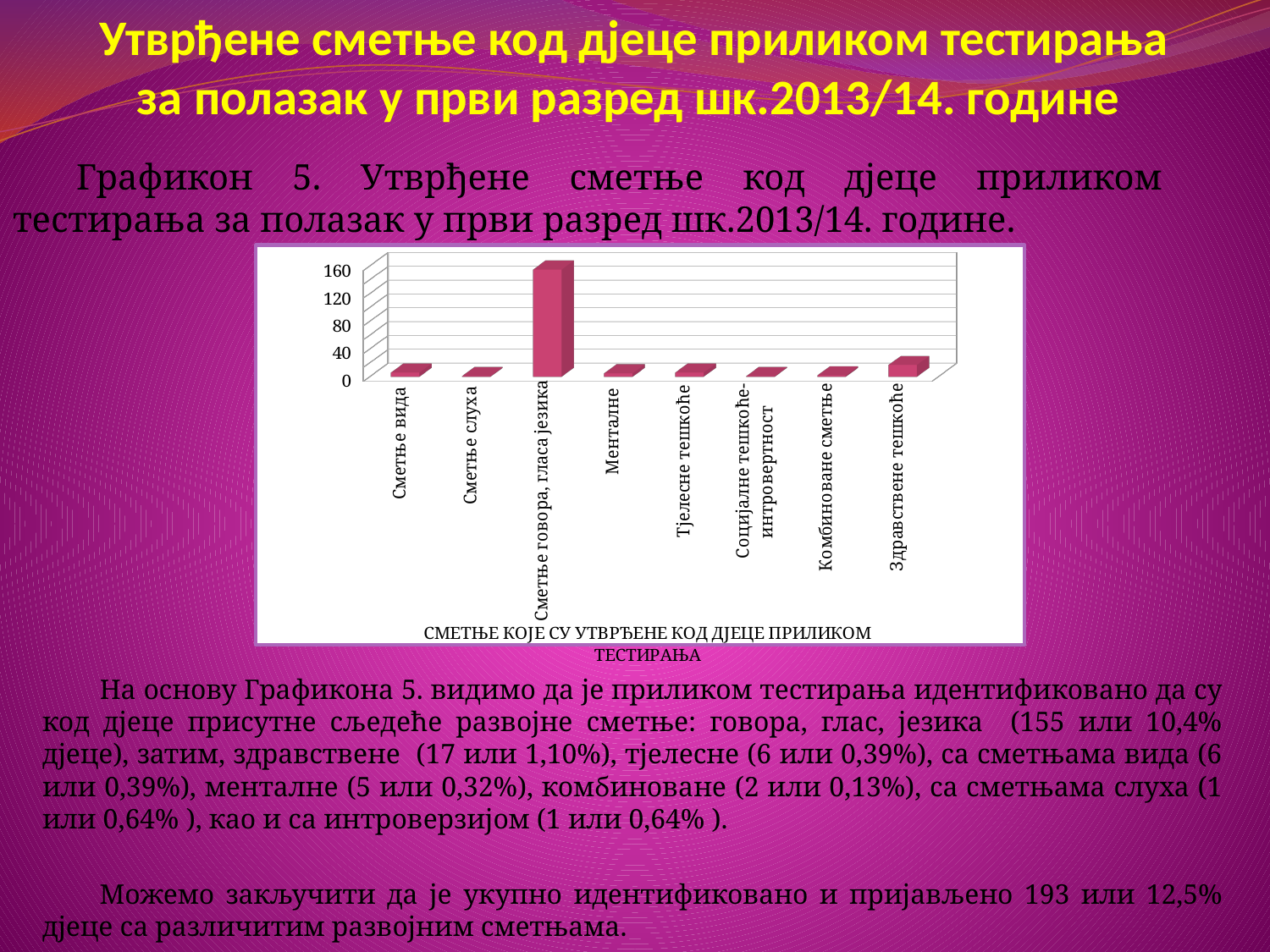
What kind of chart is shown on the slide? bar chart Is the value for Сметње говора, гласа језика greater or less than 120? greater Is the value for Менталне greater or less than 80? less What is the highest tick value shown on the vertical axis of the chart? 160 Which is larger, the value for Сметње говора, гласа језика or the value for Здравствене тешкоће? Сметње говора, гласа језика Which is larger, the value for Здравствене тешкоће or the value for Сметње слуха? Здравствене тешкоће Is the value for Здравствене тешкоће greater or less than 40? less How many categories are shown on the x axis of the chart? 8 Which category has the highest bar in the chart? Сметње говора, гласа језика What is the title printed below the x axis of the chart? СМЕТЊЕ КОЈЕ СУ УТВРЂЕНЕ КОД ДЈЕЦЕ ПРИЛИКОМ ТЕСТИРАЊА